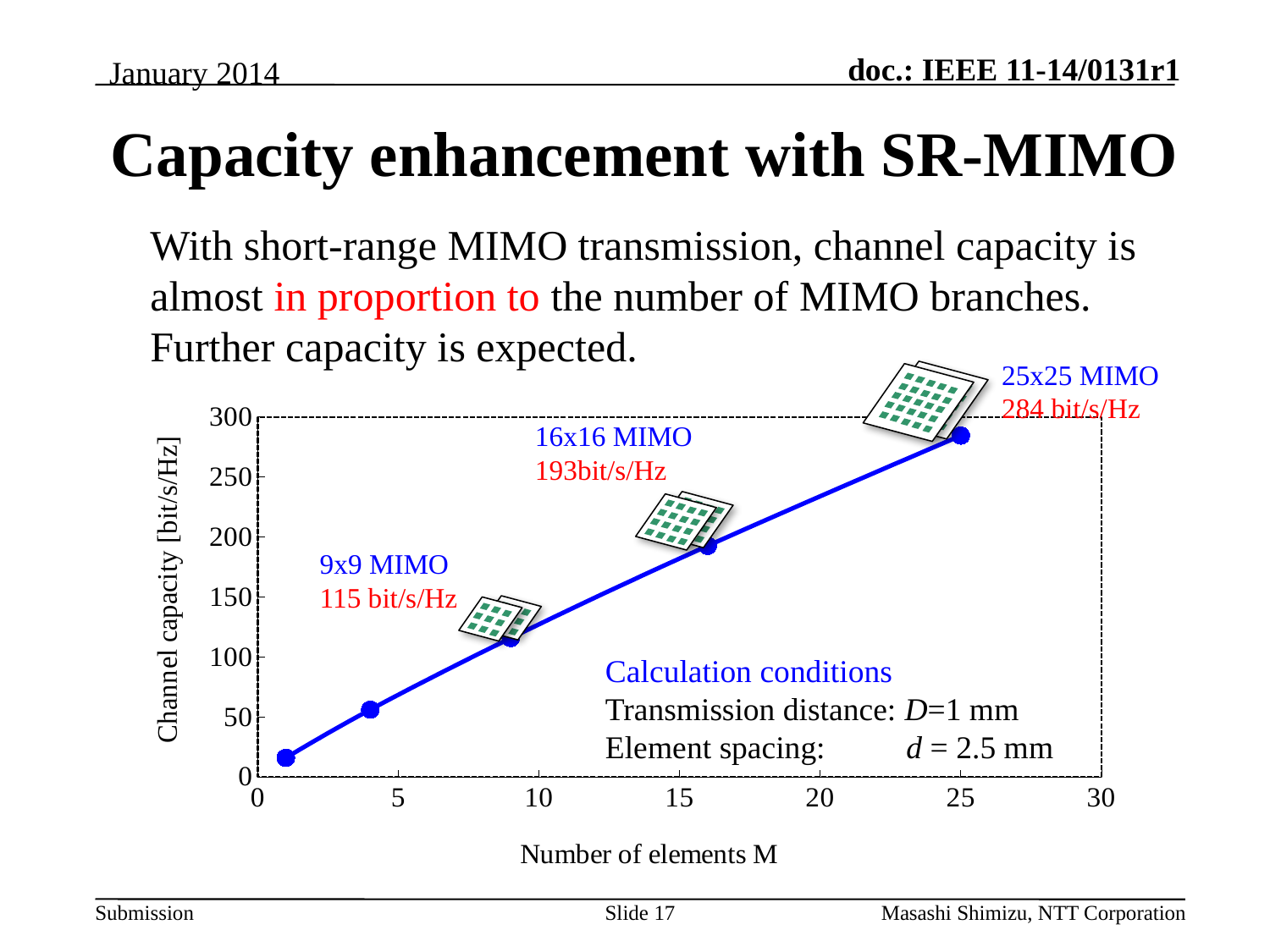
What is the channel capacity for 25x25 MIMO? 284 bit/s/Hz How many data points are plotted on the chart? 5 What is the channel capacity for 16x16 MIMO? 193bit/s/Hz What is the difference in channel capacity between 25x25 MIMO and 16x16 MIMO? 91 bit/s/Hz Which has the higher channel capacity, 9x9 MIMO or 16x16 MIMO? 16x16 MIMO Is the channel capacity at M=4 greater or less than 100 bit/s/Hz? less What is the difference in channel capacity between 16x16 MIMO and 9x9 MIMO? 78 bit/s/Hz What is the channel capacity for 9x9 MIMO? 115 bit/s/Hz What kind of chart is shown on the slide? Line chart Does channel capacity rise or fall as the number of elements M increases? Rises Which labelled MIMO configuration has the highest channel capacity? 25x25 MIMO Is the channel capacity at M=1 greater or less than 50 bit/s/Hz? less